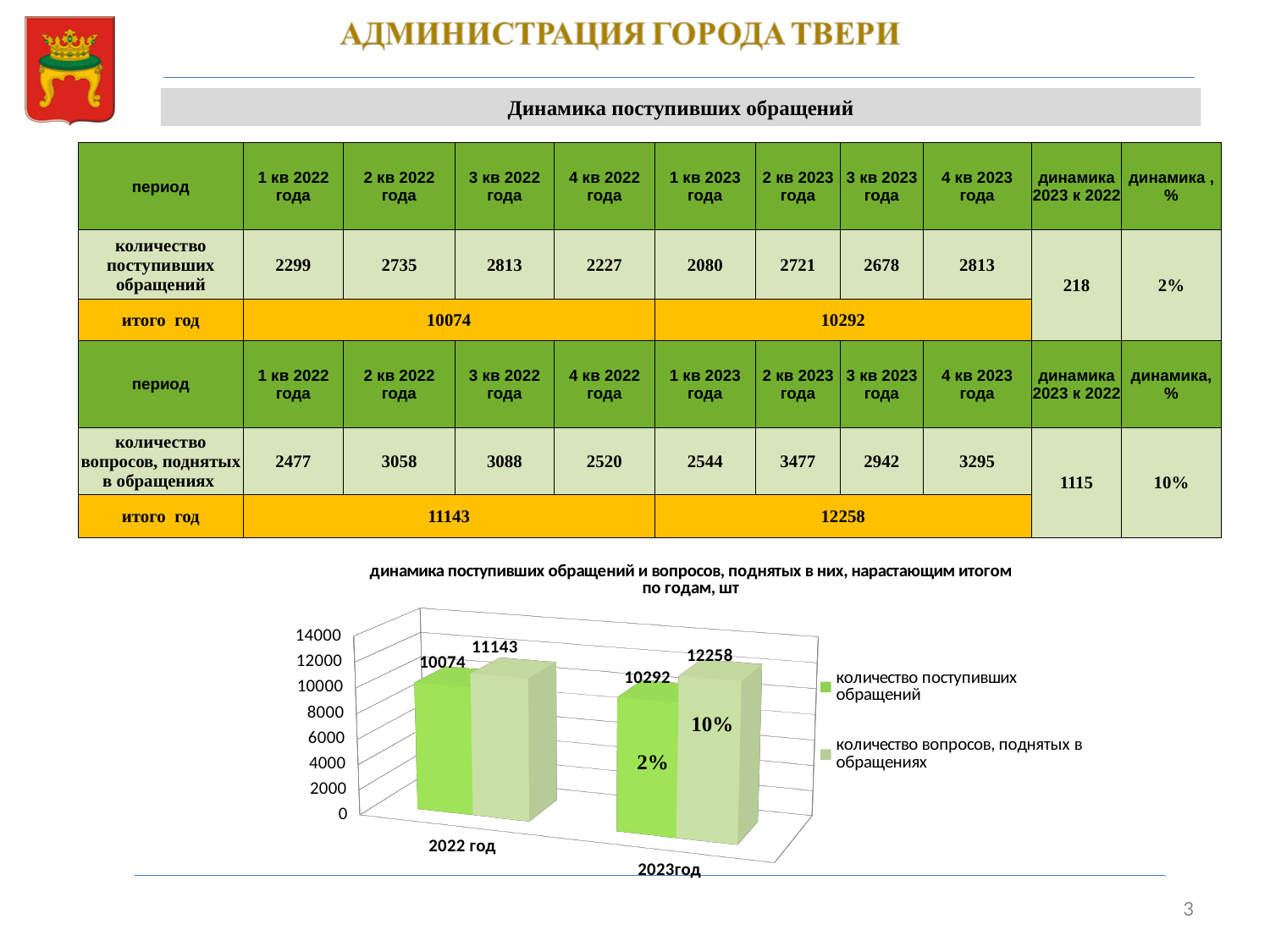
Does the value for "количество поступивших обращений" rise or fall from 2022 год to 2023год on the chart? rise Which is larger on the chart: "количество поступивших обращений" in 2023год or "количество вопросов, поднятых в обращениях" in 2022 год? количество вопросов, поднятых в обращениях in 2022 год What is the value for "количество поступивших обращений" in 2023год on the chart? 10292 How many series does the chart legend list? 2 What is the difference between "количество вопросов, поднятых в обращениях" in 2023год and in 2022 год on the chart? 1115 How many year categories are shown on the chart's x axis? 2 Which year has the higher value for "количество вопросов, поднятых в обращениях" on the chart? 2023год What is the value for "количество вопросов, поднятых в обращениях" in 2023год on the chart? 12258 What is the difference between "количество поступивших обращений" in 2023год and in 2022 год on the chart? 218 What kind of chart is shown on the slide? bar chart What is the value for "количество поступивших обращений" in 2022 год on the chart? 10074 What is the value for "количество вопросов, поднятых в обращениях" in 2022 год on the chart? 11143